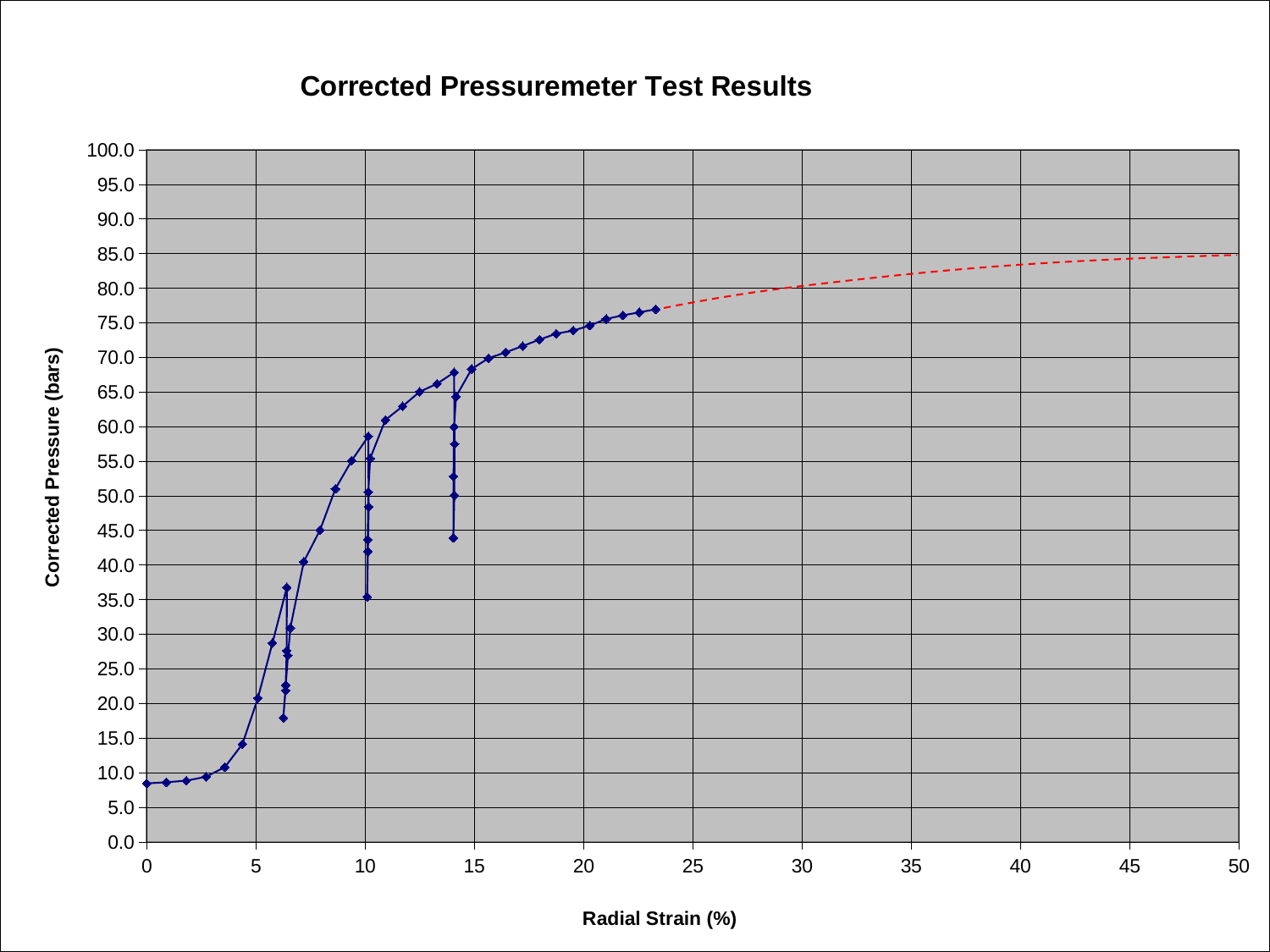
Do the corrected pressure values generally rise or fall as radial strain increases? rise Is the value of the dashed red line at a radial strain of 50% greater or less than 90.0 bars? less What is the label of the x axis? Radial Strain (%) What is the title of the chart? Corrected Pressuremeter Test Results Is the corrected pressure at a radial strain of 0% greater or less than 10.0 bars? less What kind of chart is shown on the slide? line chart Is the corrected pressure at a radial strain of 15% greater or less than 65.0 bars? greater What is the highest value shown on the y axis? 100.0